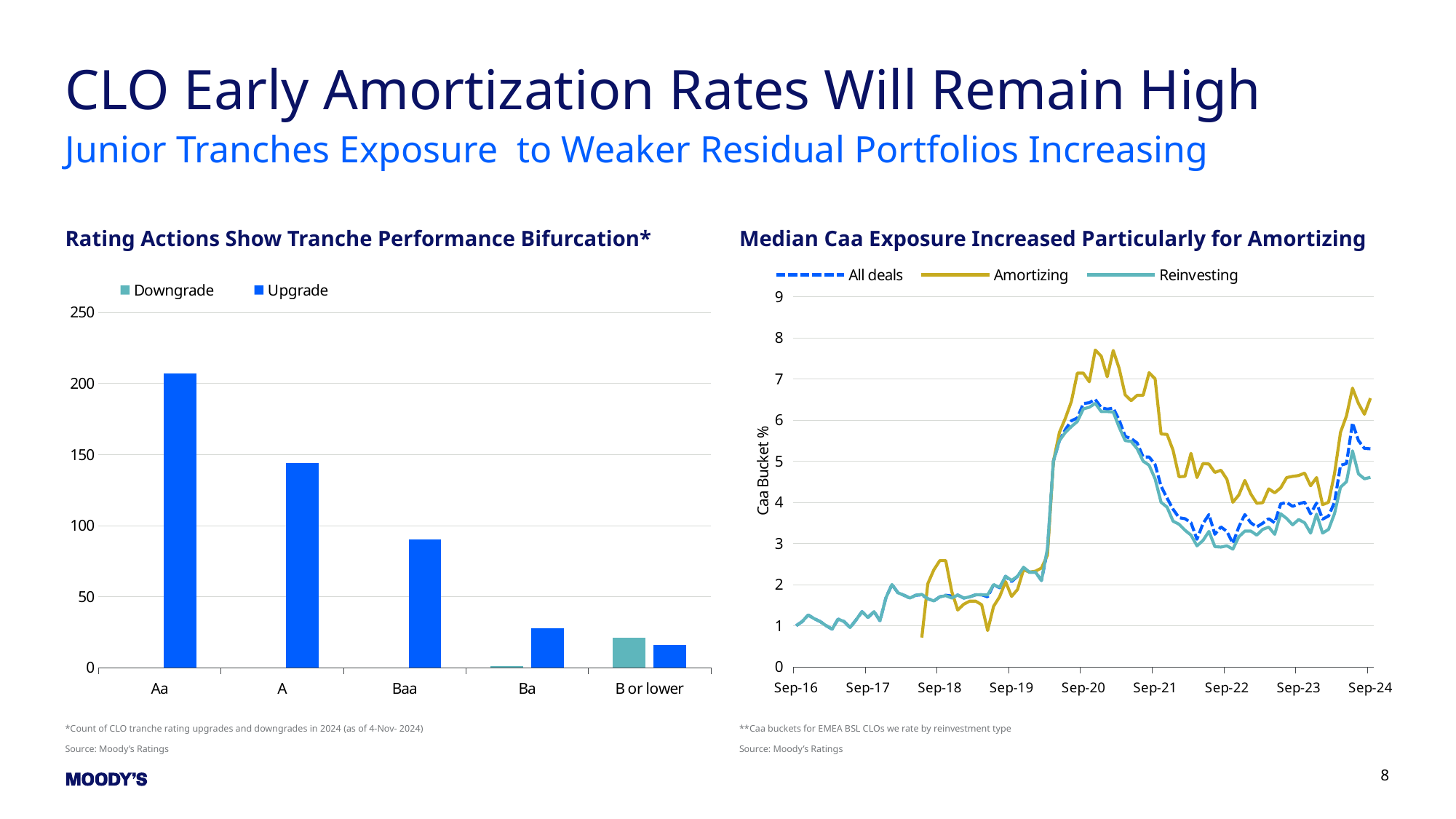
How many rating categories are shown on the x axis of the 'Rating Actions Show Tranche Performance Bifurcation*' chart? 5 What kind of chart is the 'Rating Actions Show Tranche Performance Bifurcation*' chart? Bar chart In the 'Rating Actions Show Tranche Performance Bifurcation*' chart, which rating category has the highest Upgrade count? Aa In the 'Rating Actions Show Tranche Performance Bifurcation*' chart, which is larger: the Upgrade value for A or the Upgrade value for Ba? A What kind of chart is the 'Median Caa Exposure Increased Particularly for Amortizing' chart? Line chart How many series does the legend of the 'Median Caa Exposure Increased Particularly for Amortizing' chart list? 3 How many series does the legend of the 'Rating Actions Show Tranche Performance Bifurcation*' chart list? 2 In the 'Rating Actions Show Tranche Performance Bifurcation*' chart, is the Upgrade value for Baa greater or less than 100? less What is the y-axis label of the 'Median Caa Exposure Increased Particularly for Amortizing' chart? Caa Bucket % In the 'Rating Actions Show Tranche Performance Bifurcation*' chart, do the Upgrade values rise or fall moving from Aa to B or lower? Fall In the 'Rating Actions Show Tranche Performance Bifurcation*' chart, is the Upgrade value for Aa greater or less than 200? greater In the 'Median Caa Exposure Increased Particularly for Amortizing' chart, which series reaches the highest value around Sep-20? Amortizing